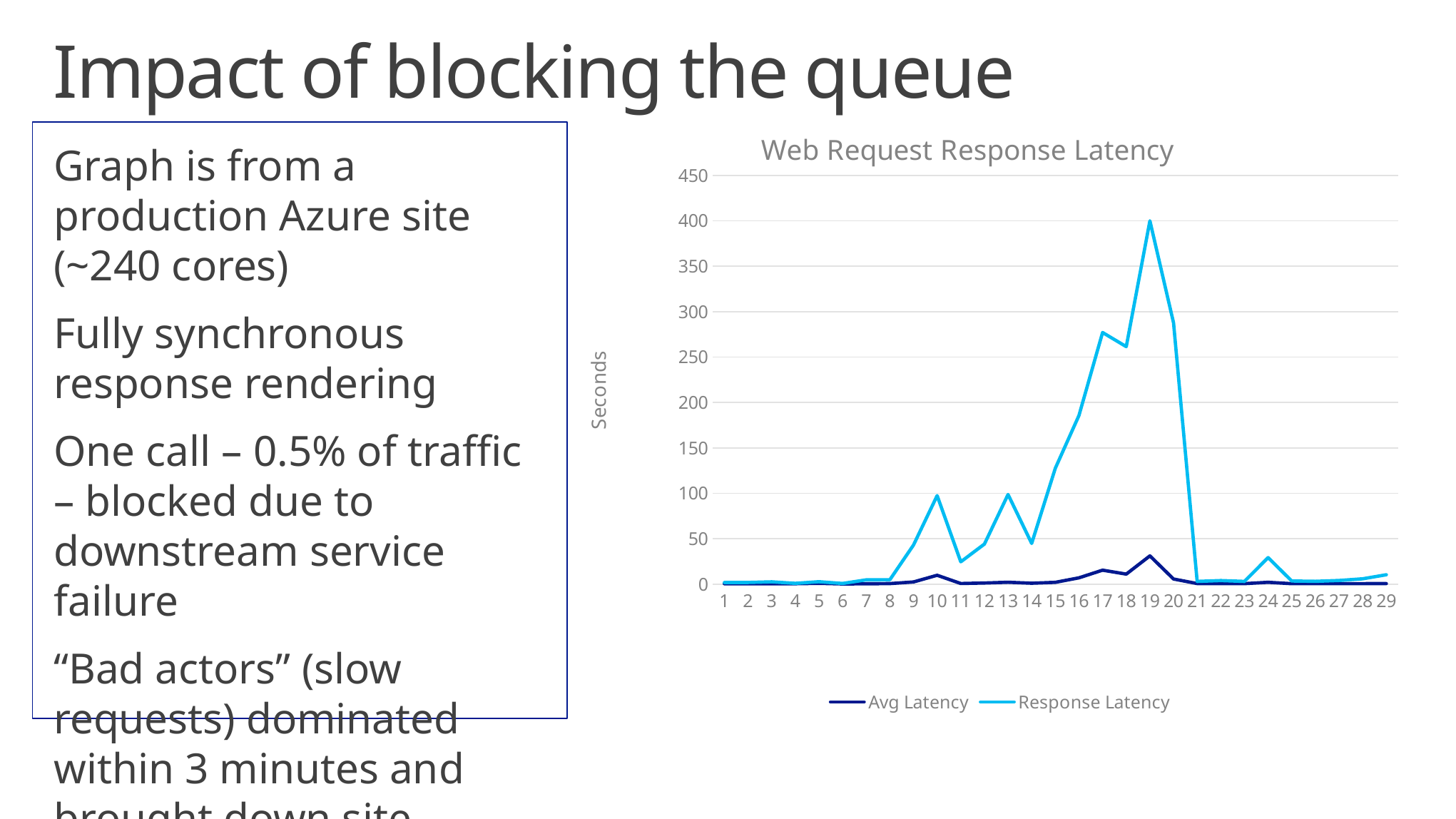
Is the Response Latency value at point 19 greater or less than 350? greater What are the names of the two series in the legend? Avg Latency and Response Latency How many series does the chart legend list? 2 What is the title of the chart? Web Request Response Latency Is the Response Latency value at point 21 greater or less than 50? less Does Response Latency rise or fall between point 19 and point 21? fall Is the Response Latency value at point 17 greater or less than 250? greater At point 19, which series has the larger value, Avg Latency or Response Latency? Response Latency How many points are on the x axis of the chart? 29 At which x-axis point does Response Latency reach its highest value? 19 What type of chart is shown on the slide? line chart